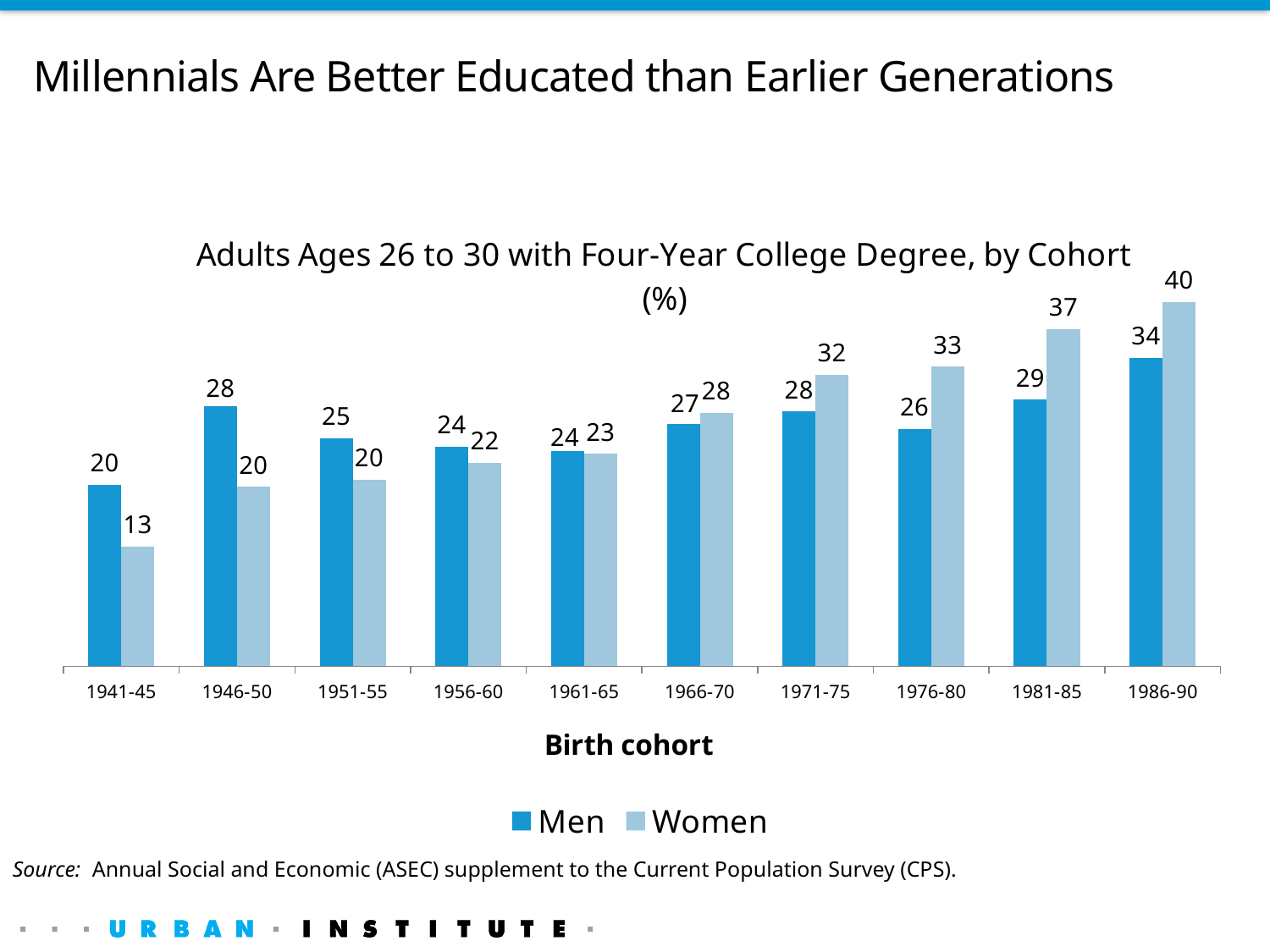
Which birth cohort has the lowest value for Women? 1941-45 What is the value for Women in the 1971-75 birth cohort? 32 Which is larger in the 1946-50 birth cohort, the value for Men or for Women? Men What kind of chart is shown on the slide? Bar chart What is the value for Men in the 1941-45 birth cohort? 20 How many birth cohorts are shown on the x axis? 10 How many series does the legend list? 2 What is the difference between the Women and Men values in the 1981-85 birth cohort? 8 Which birth cohort has the highest value for Women? 1986-90 What is the value for Women in the 1986-90 birth cohort? 40 Do the values for Women generally rise or fall from the 1941-45 cohort to the 1986-90 cohort? Rise What is the label of the x axis? Birth cohort